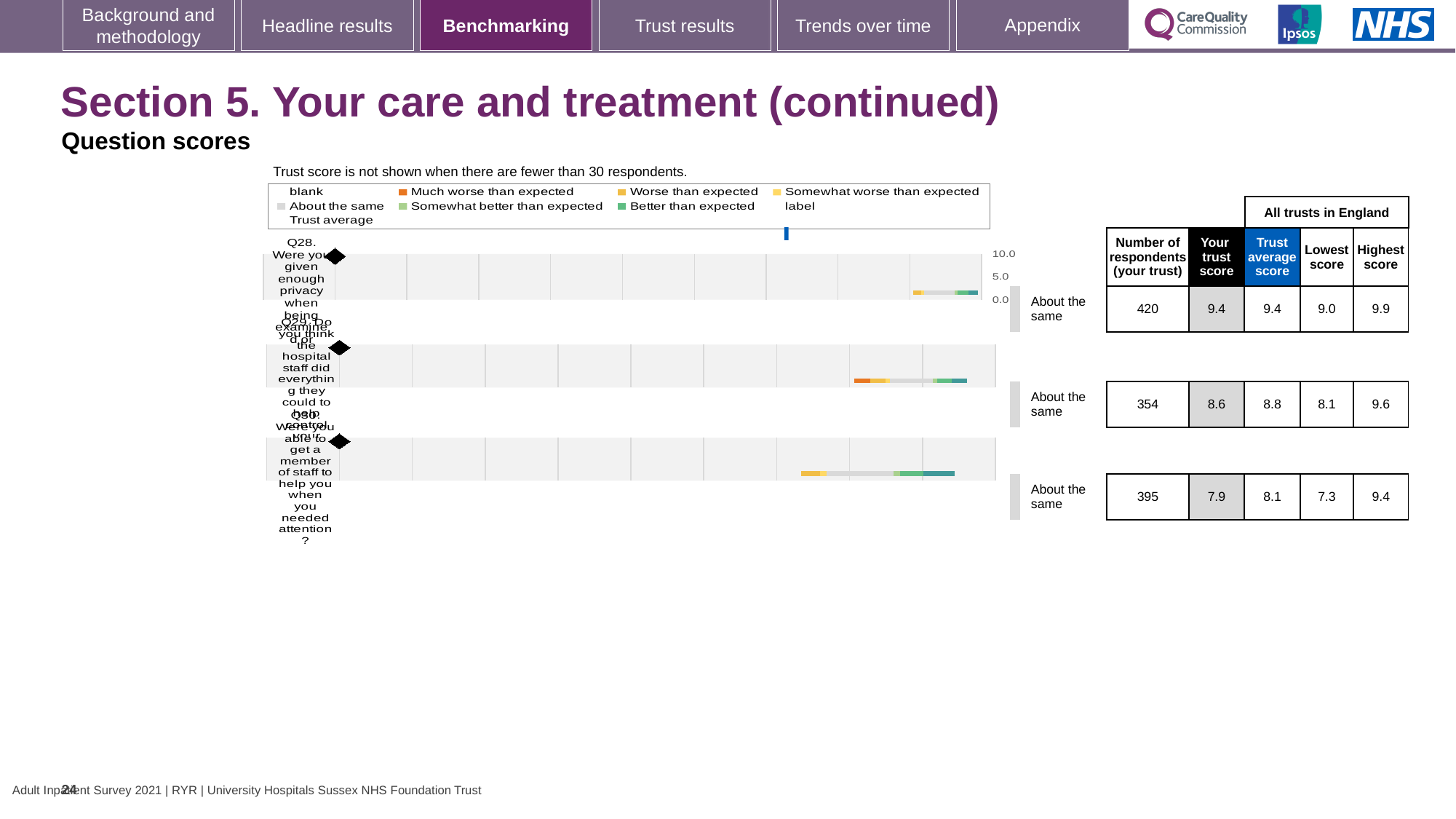
What is the highest score across all trusts in England for Q30? 9.4 What benchmark category is shown for Q29? About the same How many questions are plotted in the question scores chart? 3 Which question has the lowest 'Your trust score'? Q30 What is the difference between the 'Your trust score' for Q28 and for Q30? 1.5 What is the maximum value shown on the score axis of the chart? 10.0 Which question has the highest 'Your trust score'? Q28 How many respondents from your trust answered Q29? 354 What kind of chart is used to show the question scores for Q28, Q29 and Q30? bar chart What is the 'Your trust score' for Q28 (Were you given enough privacy when being examined or treated)? 9.4 In the chart legend, which category is shown in orange? Much worse than expected For Q29, which is larger: 'Your trust score' or the 'Trust average score'? Trust average score